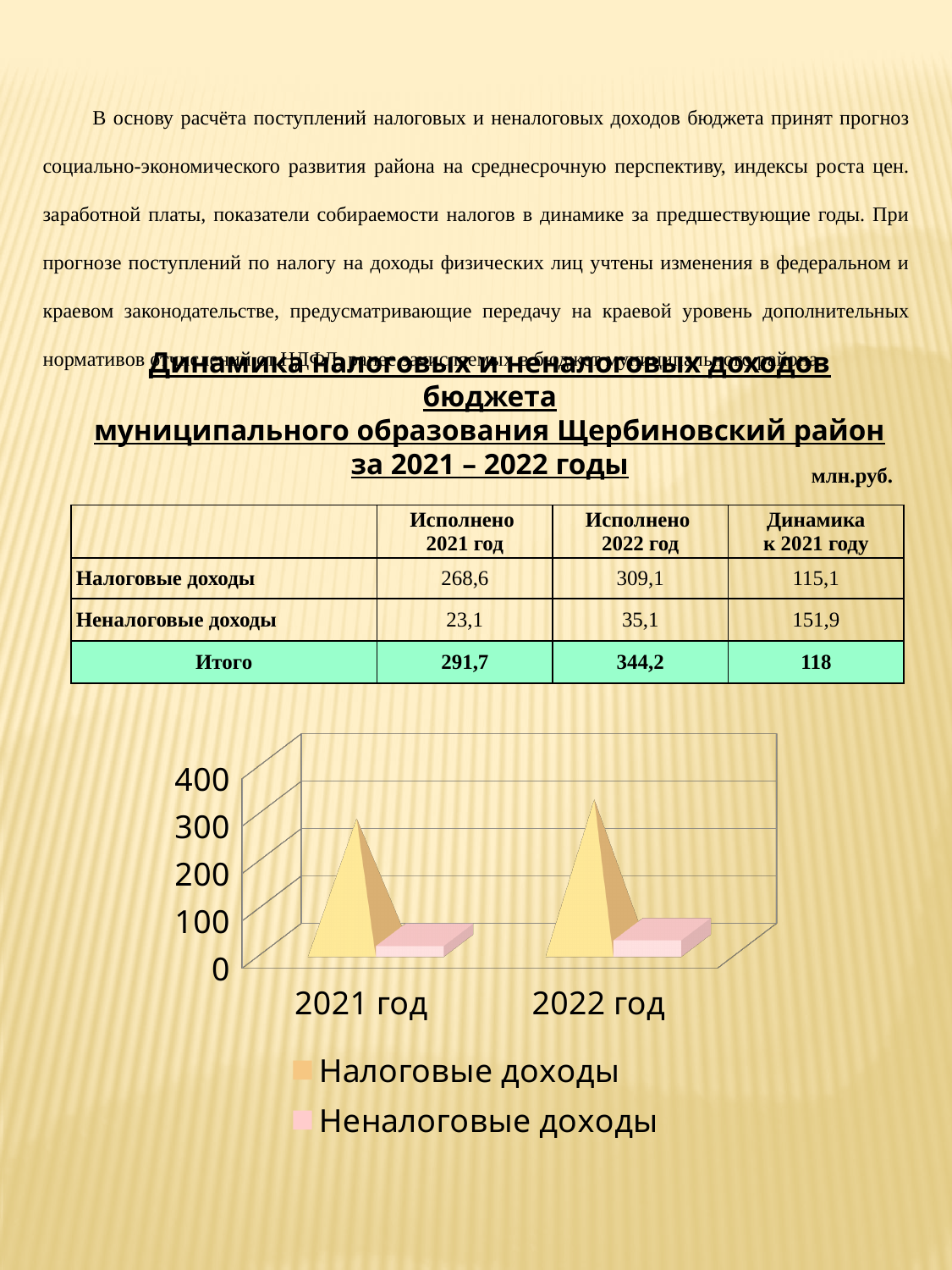
What kind of chart is shown on the slide? bar chart Which is larger: Налоговые доходы in 2021 год or in 2022 год? 2022 год Is the value for Налоговые доходы in 2021 год greater or less than 200? greater Which series has the higher value in 2022 год? Налоговые доходы Which two series are listed in the chart legend? Налоговые доходы, Неналоговые доходы Do the values for Налоговые доходы rise or fall from 2021 год to 2022 год? rise Using the table values, by how much did Налоговые доходы increase from 2021 год (268,6) to 2022 год (309,1)? 40,5 Is the value for Неналоговые доходы in 2022 год greater or less than 100? less According to the table above the chart, what is the value of Неналоговые доходы for 2022 год? 35,1 According to the table above the chart, what is the value of Налоговые доходы for 2021 год? 268,6 How many categories (years) are shown on the x axis of the chart? 2 How many series does the chart legend list? 2